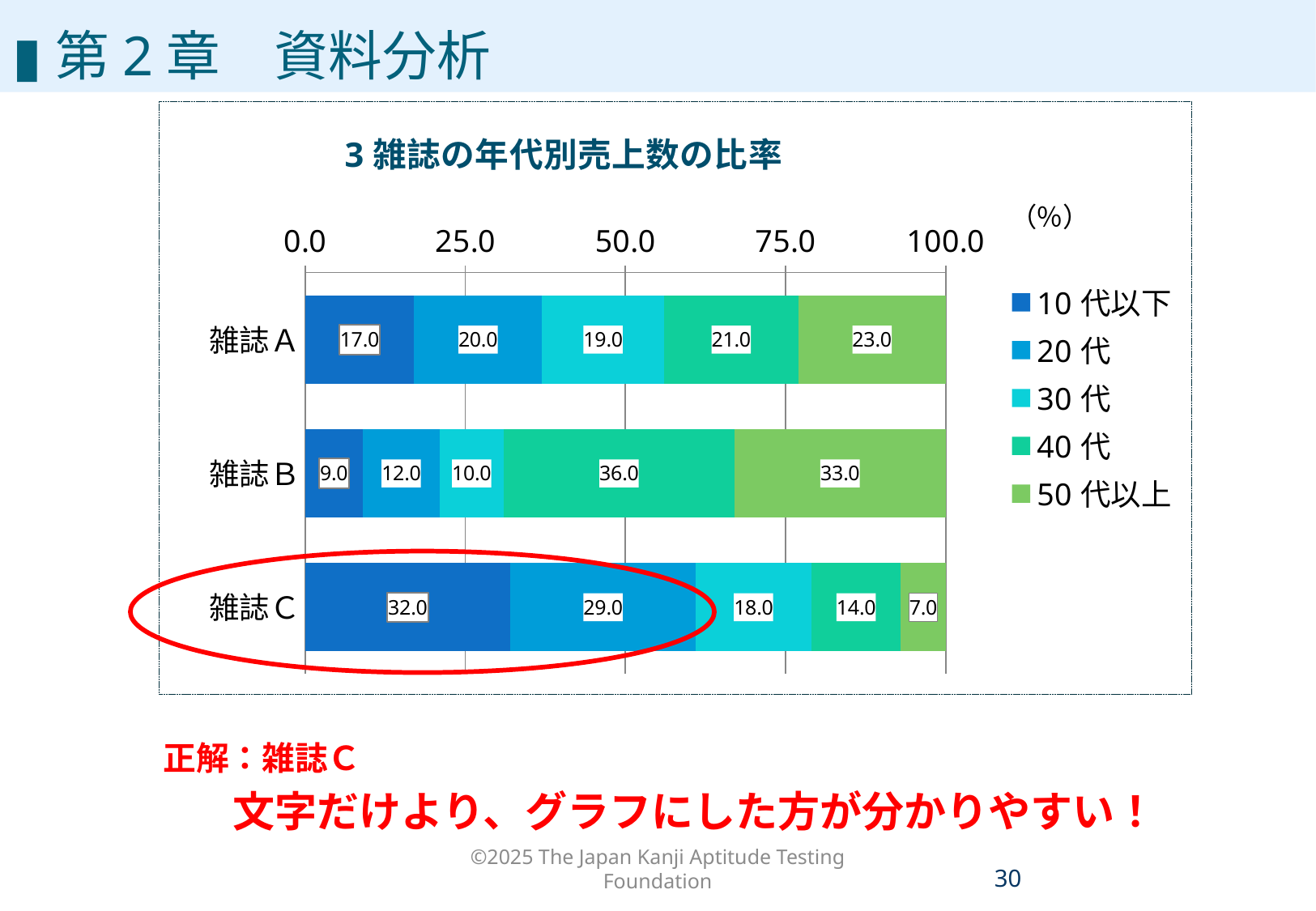
How many series does the legend list? 5 How many magazines (categories) are shown in the chart? 3 Which is larger: the 30代 value for 雑誌A or for 雑誌C? 雑誌A What is the value for 雑誌C in the 50代以上 series? 7.0 What is the title of the chart? 3雑誌の年代別売上数の比率 What is the total of the stacked bar for 雑誌B? 100.0 What is the value for 雑誌A in the 10代以下 series? 17.0 What is the difference between the 20代 values for 雑誌C and 雑誌B? 17.0 Which magazine has the highest value in the 10代以下 series? 雑誌C What kind of chart is shown on the slide? Stacked bar chart What is the value for 雑誌B in the 40代 series? 36.0 Which magazine has the lowest value in the 50代以上 series? 雑誌C